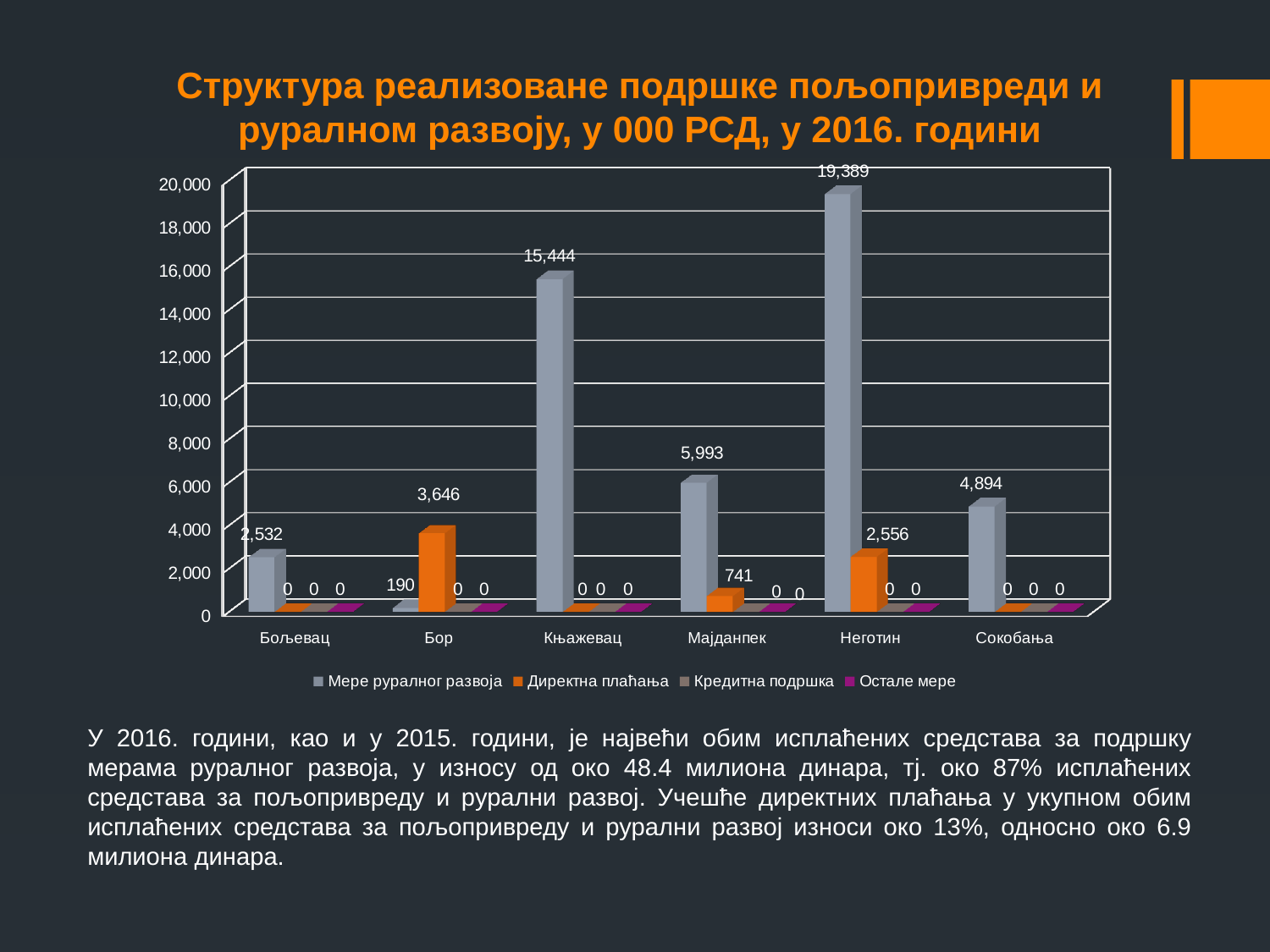
How many categories (municipalities) are shown on the x axis? 6 Which series is shown in orange in the legend? Директна плаћања What is the value of Директна плаћања for Неготин? 2,556 What is the value of Мере руралног развоја for Књажевац? 15,444 What type of chart is shown on the slide? Bar chart Which municipality has the lowest value for Мере руралног развоја? Бор What is the value of Директна плаћања for Мајданпек? 741 Which municipality has the highest value for Мере руралног развоја? Неготин How many series does the legend list? 4 What is the difference between the Мере руралног развоја values for Неготин and Књажевац? 3,945 Which is larger: Мере руралног развоја for Мајданпек or for Сокобања? Мајданпек What is the value of Директна плаћања for Бор? 3,646